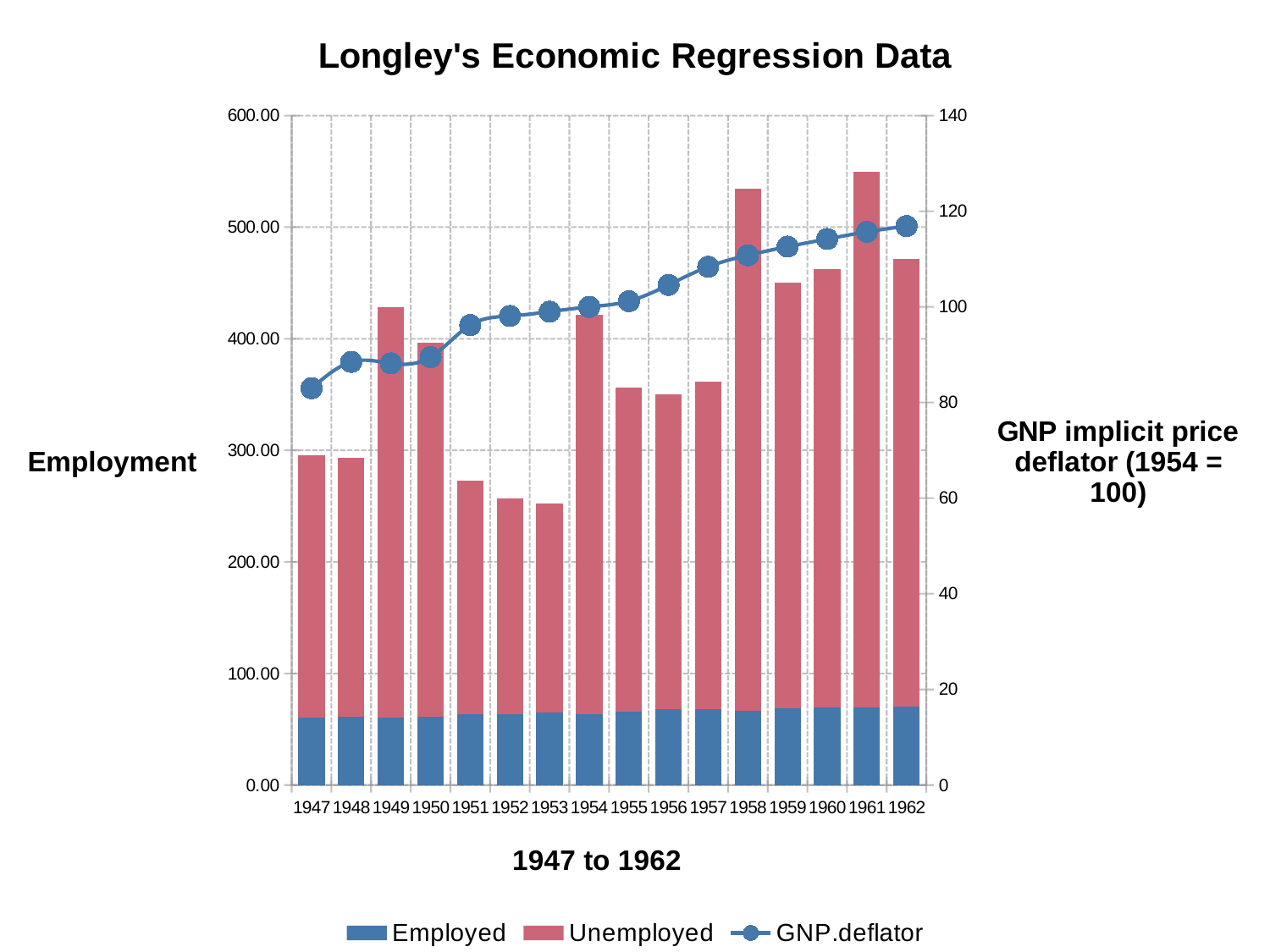
Does the GNP.deflator line generally rise or fall from 1947 to 1962? Rise How many years are shown along the x axis? 16 What kind of chart is shown on the slide? A stacked bar chart combined with a line chart Which year has the tallest stacked bar (Employed plus Unemployed)? 1961 How many series does the legend list? 3 What is the title of the chart? Longley's Economic Regression Data Which year has the taller stacked bar, 1958 or 1959? 1958 Is the GNP.deflator value for 1947 greater or less than 100? less Is the total stacked bar for 1961 greater or less than 500? greater In which year is the GNP.deflator line at its lowest? 1947 In which year is the GNP.deflator line at its highest? 1962